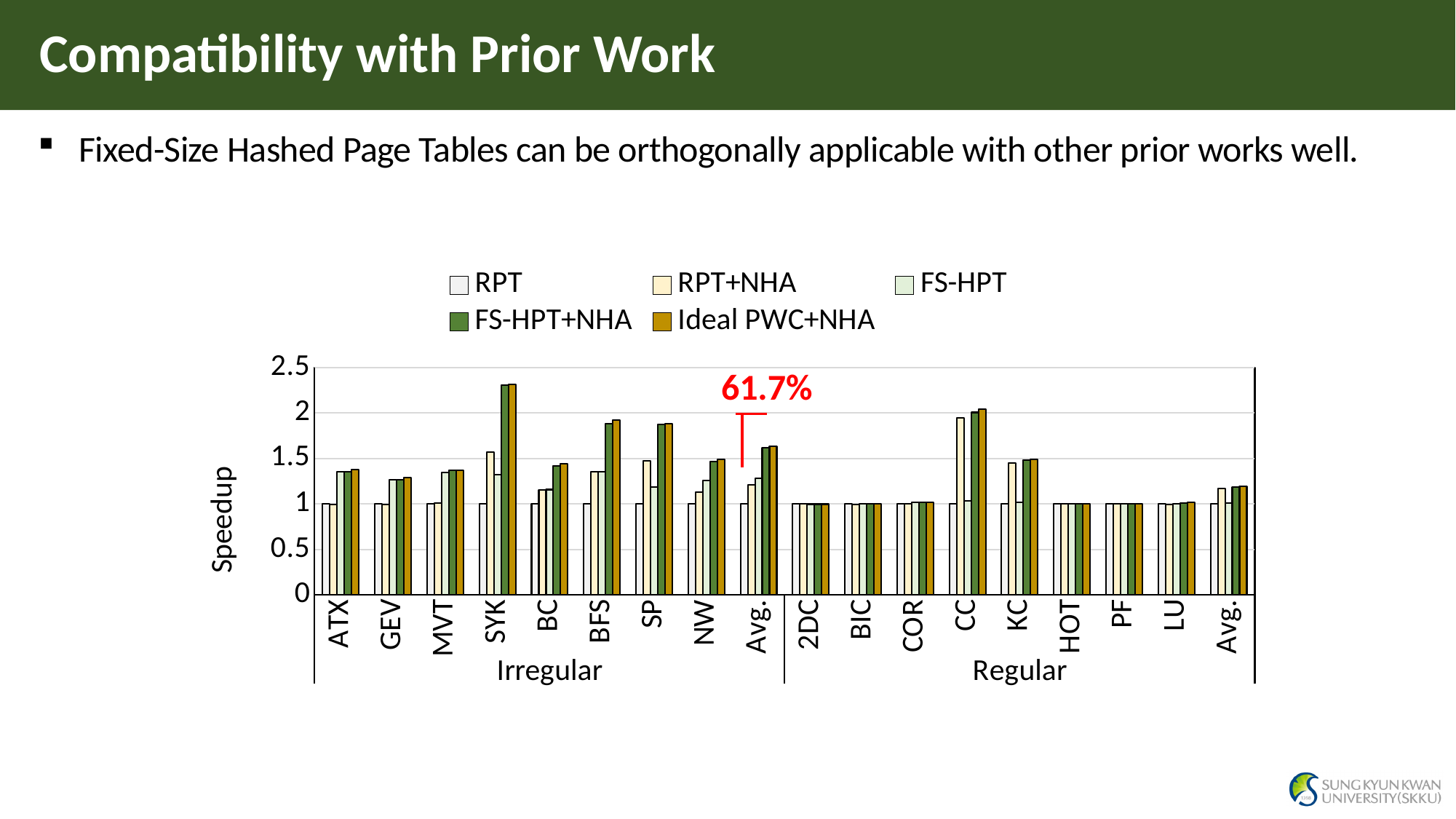
Is the FS-HPT+NHA value for BFS greater or less than 1.5? greater Which has the larger Ideal PWC+NHA value, KC or HOT? KC Is the FS-HPT+NHA value for SYK greater or less than 2? greater What is the label of the y axis? Speedup How many series does the legend list? 5 Is the Ideal PWC+NHA value for ATX greater or less than 1.5? less What kind of chart is shown on the slide? bar chart How many categories are shown along the x axis? 18 Which has the larger Ideal PWC+NHA value, SYK or BFS? SYK What percentage is annotated in red above the Irregular Avg. group? 61.7% Which category has the highest FS-HPT+NHA bar? SYK